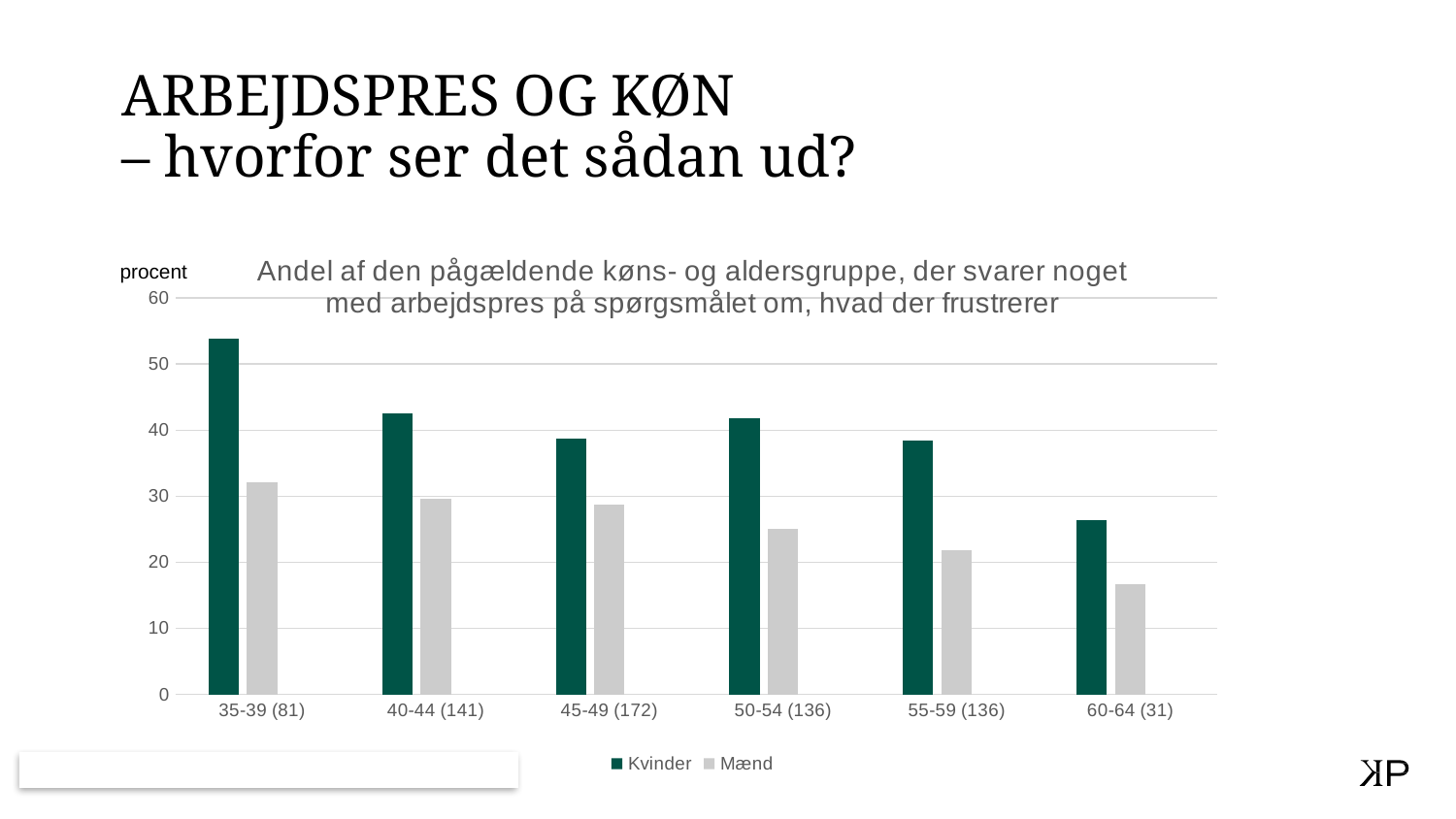
Which age group has the highest value for Kvinder? 35-39 (81) Which age group has the lowest value for Mænd? 60-64 (31) Do the values for Mænd rise or fall as the age groups increase along the x axis? fall How many age groups are shown on the x axis? 6 Is the value for Kvinder in the 60-64 (31) group greater or less than 30? less What kind of chart is shown on the slide? bar chart In the 50-54 (136) group, which series has the larger value, Kvinder or Mænd? Kvinder Is the value for Mænd in the 60-64 (31) group greater or less than 20? less Which age group has the lowest value for Kvinder? 60-64 (31) How many series does the legend list? 2 Is the value for Kvinder in the 35-39 (81) group greater or less than 50? greater What unit is shown at the top of the vertical axis? procent